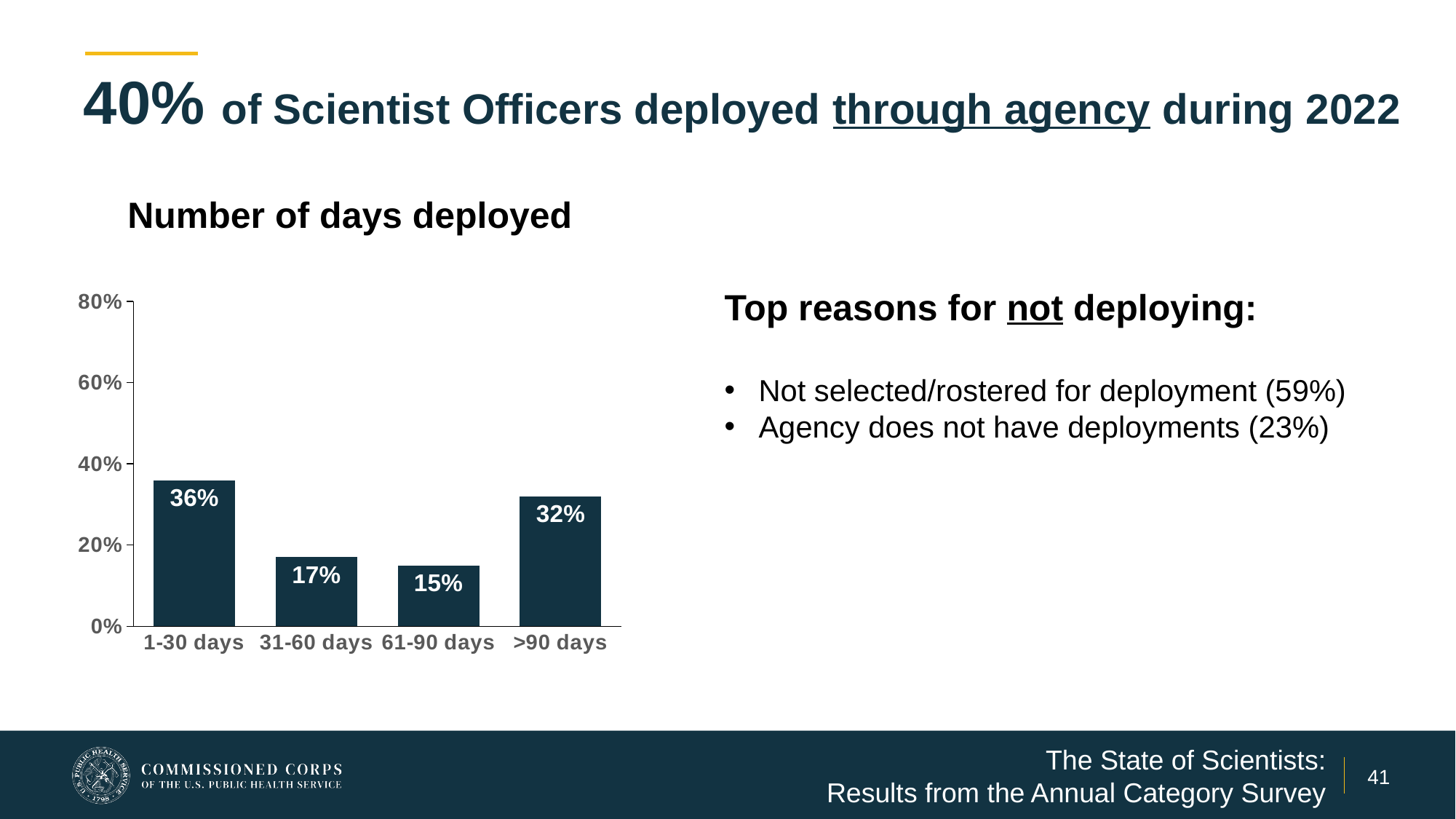
What is the value shown for the 31-60 days category? 17% How many categories are shown on the x axis of the chart? 4 What is the value shown for the 61-90 days category? 15% What kind of chart is used to show the number of days deployed? bar chart What is the difference between the 1-30 days value and the >90 days value? 4% What percentage deployed for more than 90 days? 32% Which number-of-days category has the highest value? 1-30 days Is the value for 1-30 days greater or less than 40%? less What percentage of Scientist Officers deployed for 1-30 days? 36% Which number-of-days category has the lowest value? 61-90 days What is the title of the chart? Number of days deployed Which is larger, the value for 31-60 days or the value for >90 days? >90 days